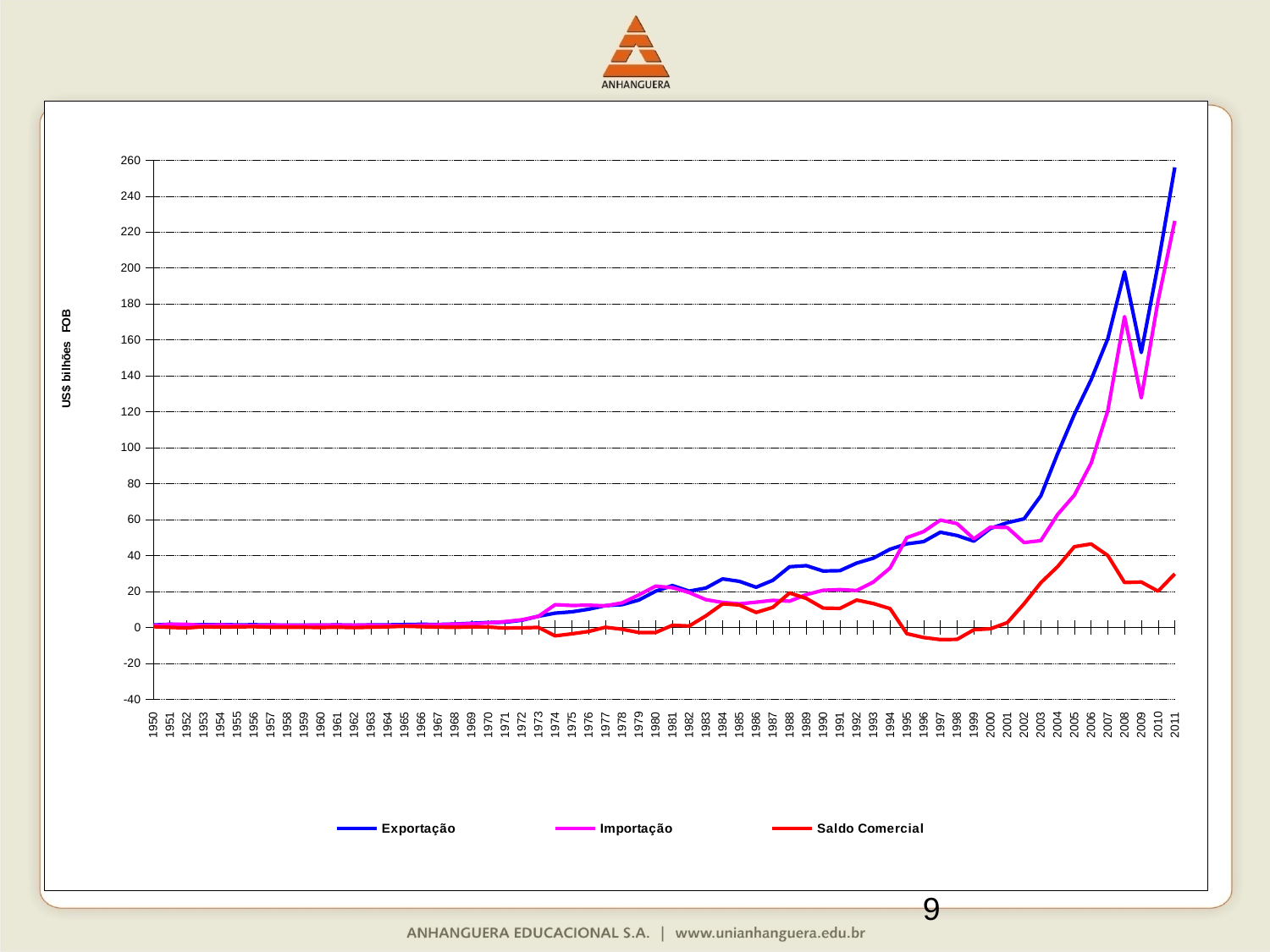
What kind of chart is shown on the slide? line chart In 2011, which is larger, Exportação or Importação? Exportação Is the value of Importação in 2011 greater or less than 200? greater What is the label of the vertical axis? US$ bilhões FOB Is the value of Exportação in 2008 greater or less than 180? greater How many years are plotted along the x axis? 62 In which year does Exportação reach its highest value? 2011 Is the value of Exportação in 2011 greater or less than 240? greater How many series does the legend list? 3 Which series is drawn in blue? Exportação Does Exportação rise or fall between 2002 and 2008? rise